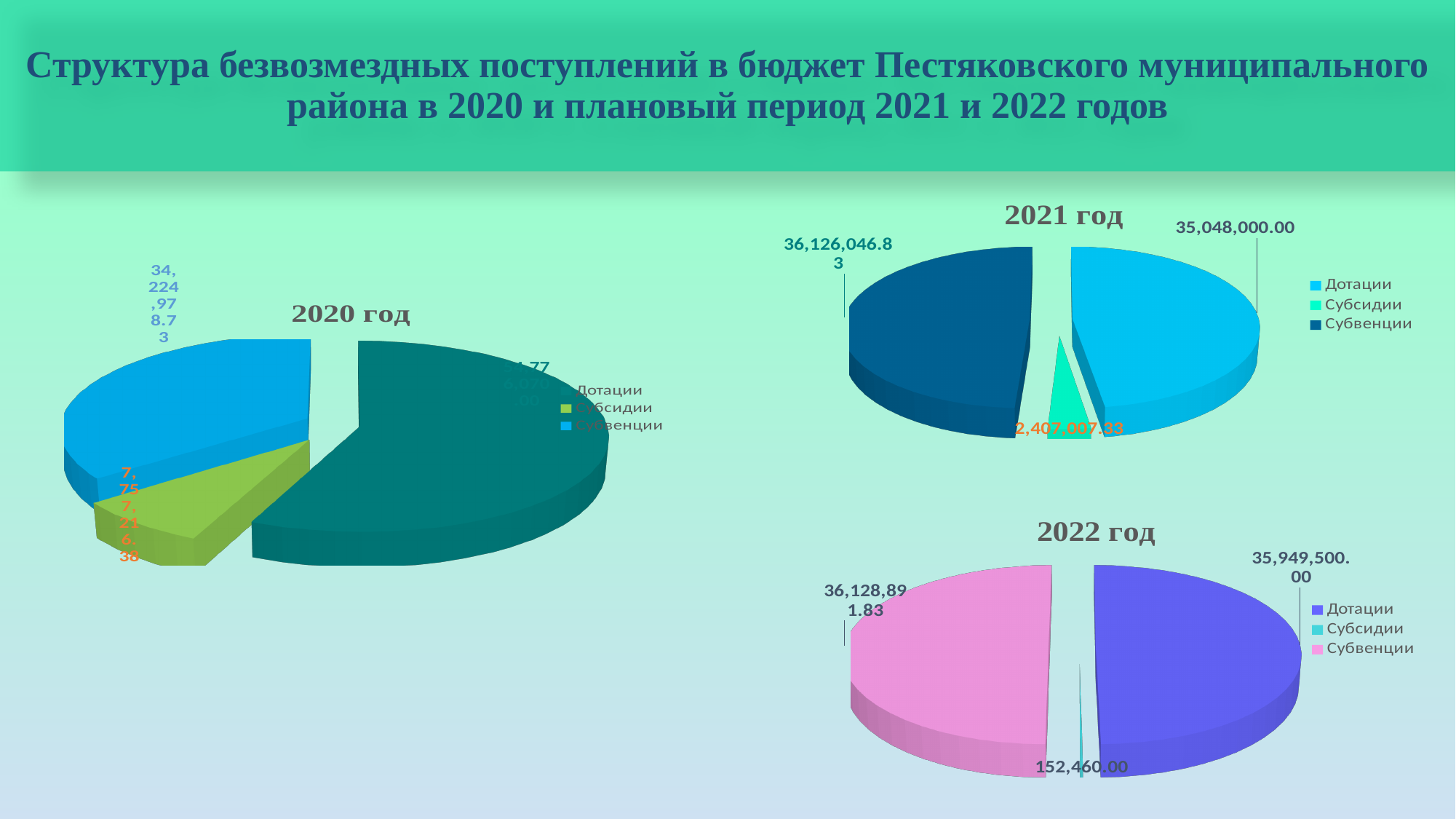
How many entries does the legend of the "2022 год" chart list? 3 In the "2021 год" chart, what is the value for Дотации? 35,048,000.00 In the "2020 год" chart, what is the value for Субвенции? 34,224,978.73 In the "2022 год" chart, what is the value for Дотации? 35,949,500.00 In the "2022 год" chart, which category has the smallest value? Субсидии In the "2022 год" chart, what is the value for Субсидии? 152,460.00 In the "2022 год" chart, what is the value for Субвенции? 36,128,891.83 In the "2021 год" chart, what is the value for Субвенции? 36,126,046.83 What kind of chart is the "2021 год" chart? Pie chart In the "2021 год" chart, what is the value for Субсидии? 2,407,007.33 In the "2020 год" chart, which category has the smallest slice? Субсидии In the "2021 год" chart, what is the difference between Субвенции and Дотации? 1,078,046.83